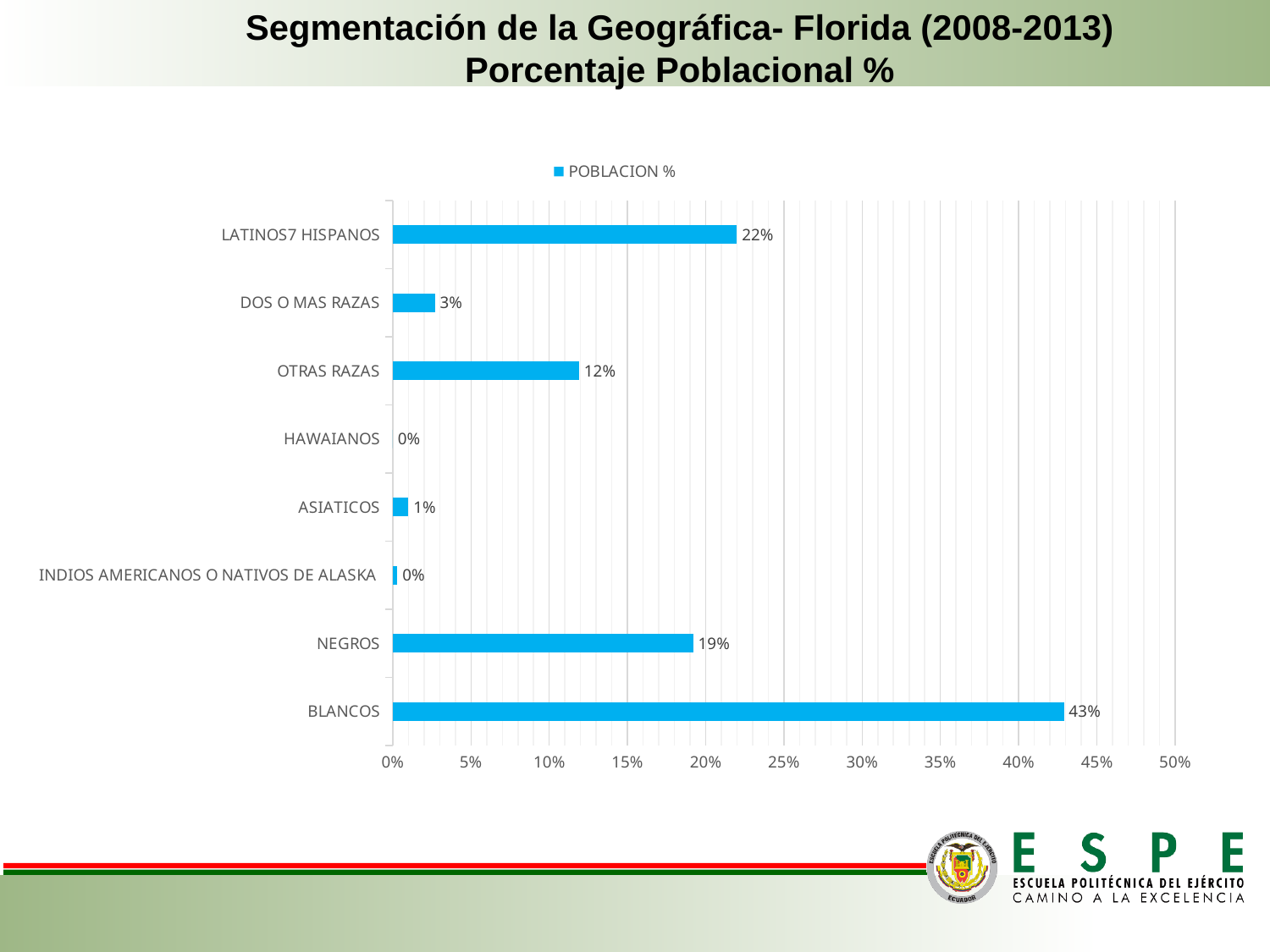
What kind of chart is shown on the slide? bar chart How many categories are shown on the chart? 8 Which category has the highest value? BLANCOS Is the value for BLANCOS greater or less than 40%? greater Which is larger, the value for NEGROS or the value for LATINOS7 HISPANOS? LATINOS7 HISPANOS What is the value for OTRAS RAZAS? 12% What is the value for NEGROS? 19% What series name does the legend show? POBLACION % What is the value for LATINOS7 HISPANOS? 22% What is the value for BLANCOS? 43% What is the difference between the values for BLANCOS and NEGROS? 24% What is the difference between the values for LATINOS7 HISPANOS and OTRAS RAZAS? 10%